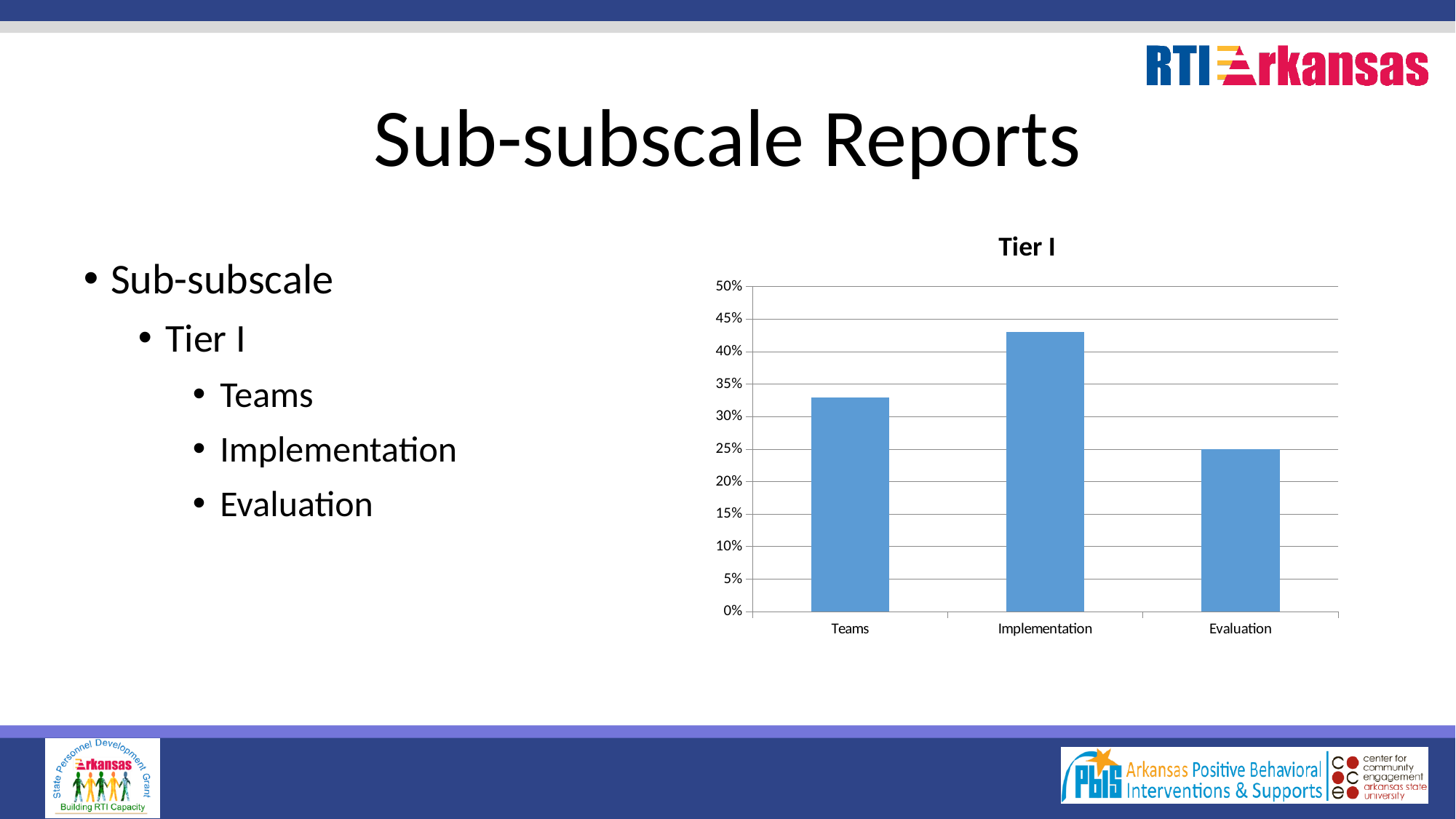
Is the value for Teams greater or less than 35%? less What is the highest value shown on the y axis of the chart? 50% Which category has the highest value in the chart? Implementation What is the value for Evaluation? 25% What kind of chart is shown on the slide? bar chart Which is larger, the value for Teams or the value for Evaluation? Teams Which category has the lowest value in the chart? Evaluation Is the value for Teams greater or less than 30%? greater Is the value for Implementation greater or less than 45%? less How many categories are shown on the x axis of the chart? 3 What is the title of the chart? Tier I